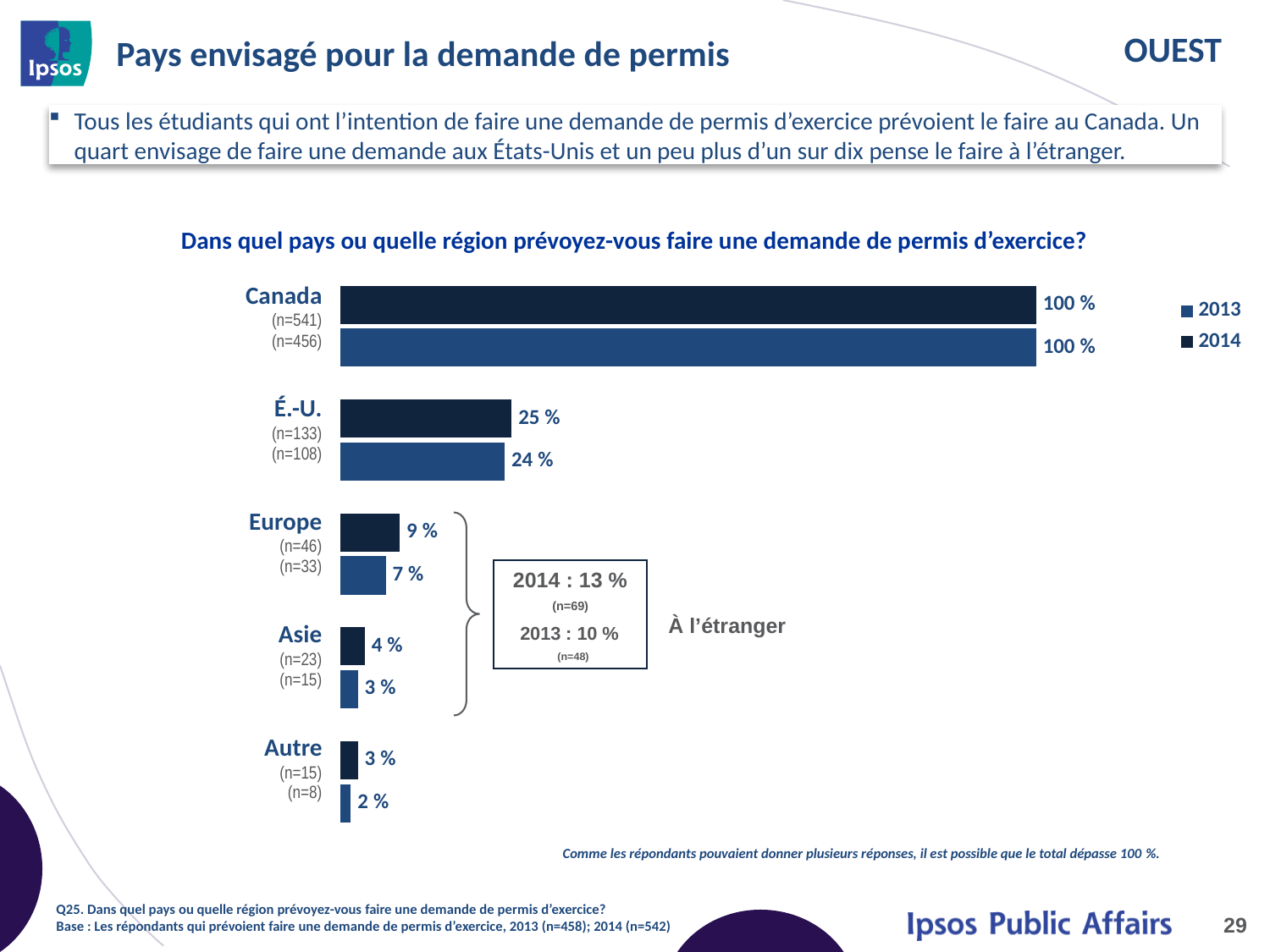
What is the difference between the 2013 and 2014 values for Europe? 2 % How many series does the legend list? 2 How many countries or regions are plotted in the chart? 5 What is the 2014 value for Europe? 9 % What is the 2013 value for É.-U.? 24 % Which is larger for É.-U.: the 2013 value or the 2014 value? 2014 Which country or region has the lowest value in 2014? Autre Which country or region has the highest value in 2014? Canada What is the 2014 value for Asie? 4 % What is the 2013 value for Autre? 2 % What kind of chart is shown on the slide? bar chart